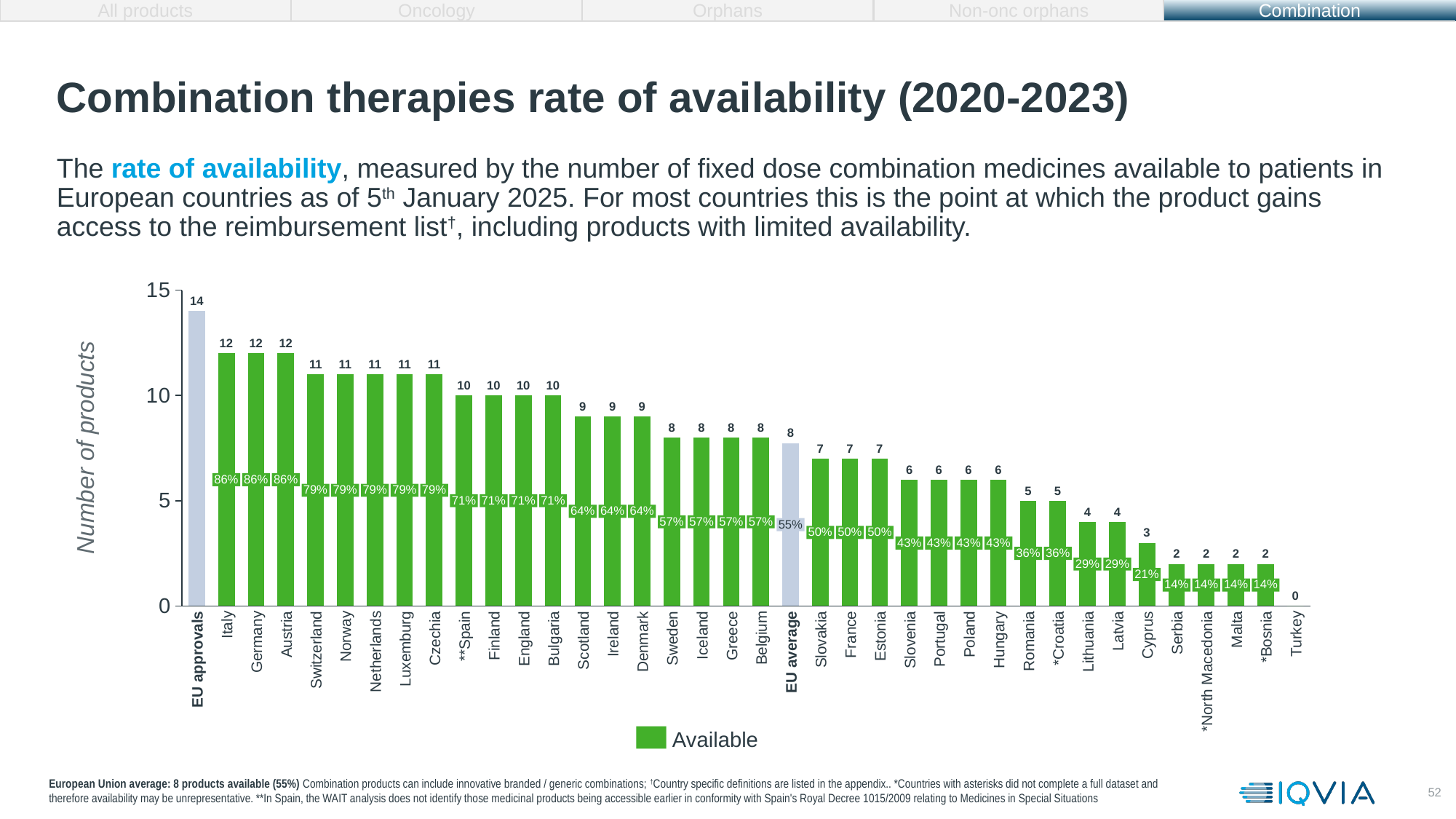
What is the number of products for Italy? 12 Is the value for Hungary greater or less than 5? greater Which category has the highest number of products? EU approvals How many bars are plotted in the chart? 38 What is the number of products for Cyprus? 3 What kind of chart is shown on the slide? Bar chart Which has more products, Finland or Denmark? Finland Which country has the lowest number of products? Turkey What is the difference in number of products between EU approvals and Germany? 2 What percentage is shown on the bar for Switzerland? 79% What is the label of the y axis? Number of products What percentage is shown on the EU average bar? 55%